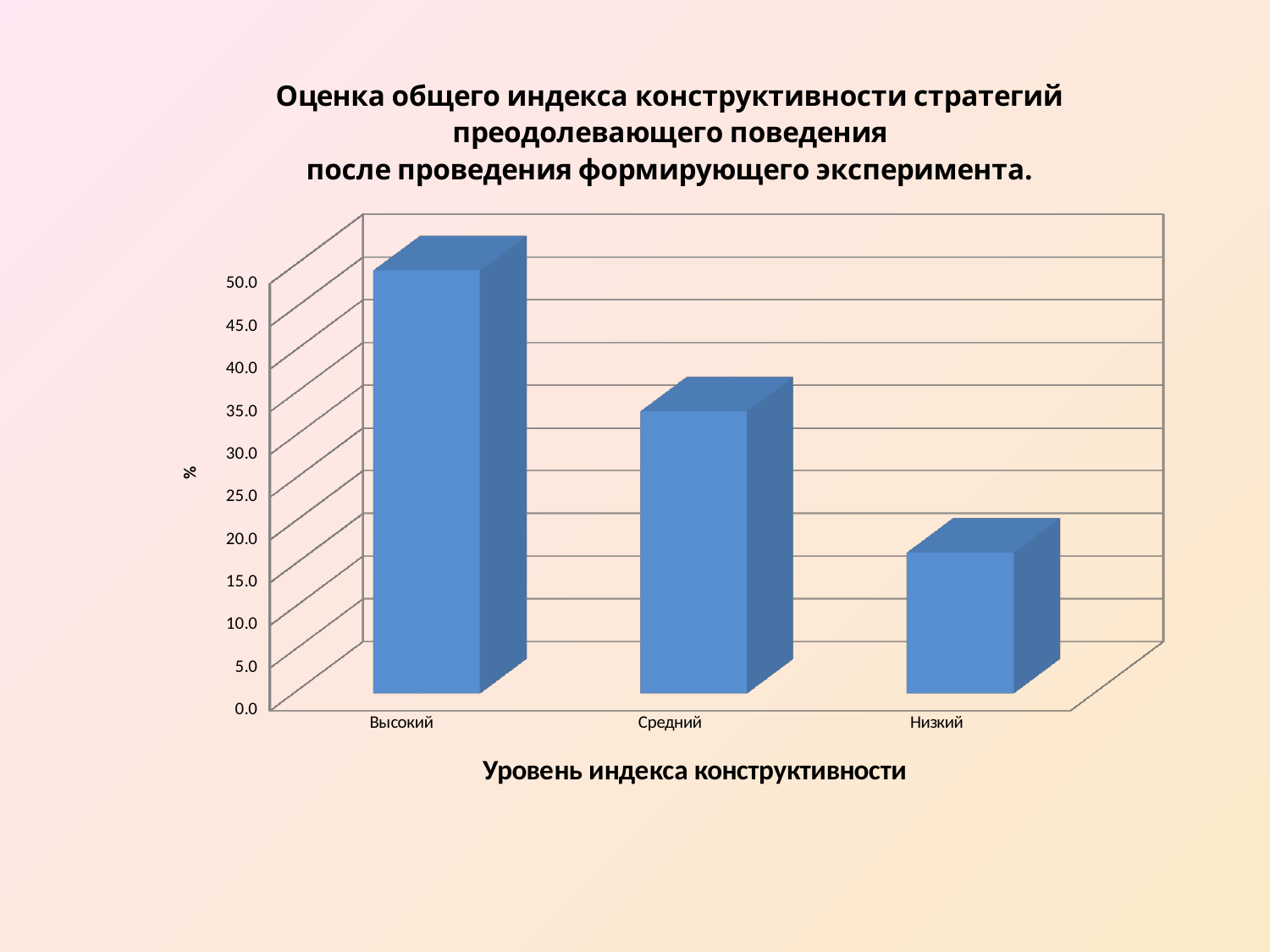
What is the label of the y axis of the chart? % Which category has the highest value in the chart? Высокий Which category has the lowest value in the chart? Низкий What is the label of the x axis of the chart? Уровень индекса конструктивности Which is larger, the value for Высокий or the value for Средний? Высокий Is the value for Средний greater or less than 25.0? greater What kind of chart is shown on the slide? bar chart Which is larger, the value for Средний or the value for Низкий? Средний How many categories are shown on the x axis of the chart? 3 Do the values rise or fall moving from Высокий to Низкий along the x axis? fall Is the value for Низкий greater or less than 25.0? less Is the value for Высокий greater or less than 40.0? greater